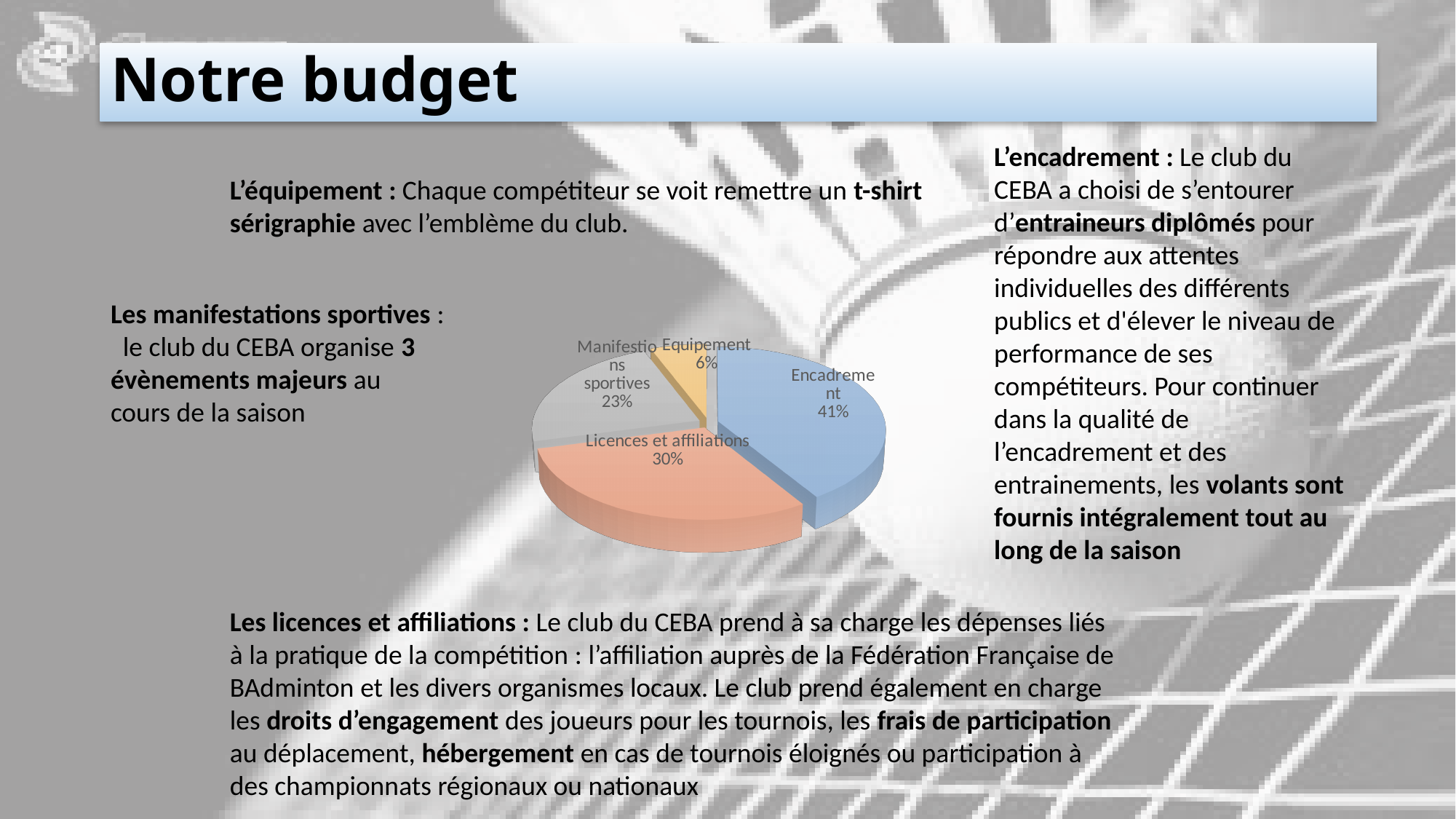
What share of the pie chart does Manifestions sportives represent? 23% How many slices does the pie chart have? 4 What share of the pie chart does Equipement represent? 6% What share of the pie chart does Licences et affiliations represent? 30% Which category has the smallest slice of the pie chart? Equipement What is the difference in percentage points between Manifestions sportives and Equipement? 17 Which category has the largest slice of the pie chart? Encadrement What share of the pie chart does Encadrement represent? 41% Which is larger in the pie chart, Licences et affiliations or Manifestions sportives? Licences et affiliations What is the difference in percentage points between Encadrement and Licences et affiliations? 11 What colour is the Encadrement slice of the pie chart? Blue What type of chart is shown on the slide? Pie chart